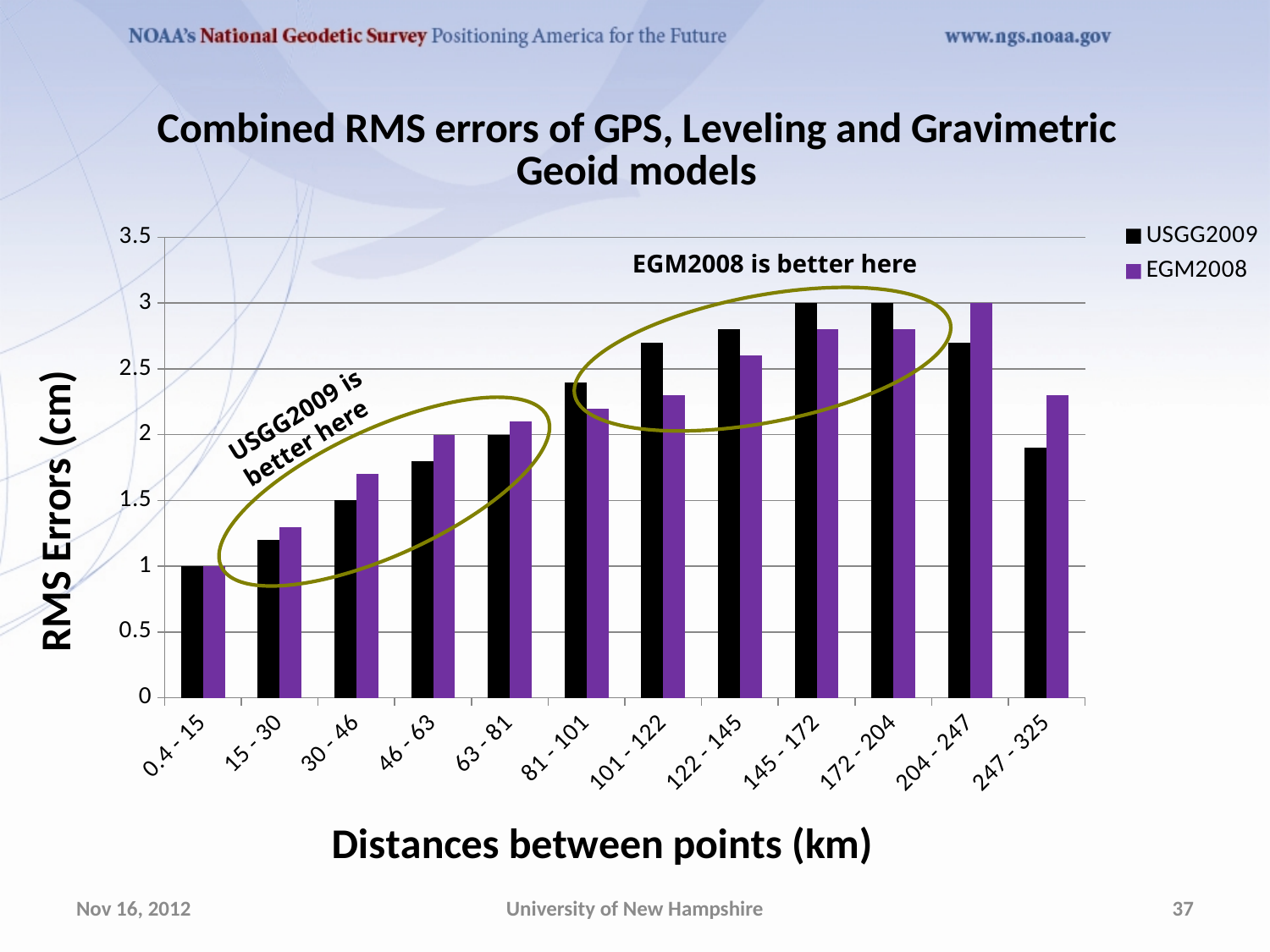
For which distance range is the USGG2009 RMS error lowest? 0.4 - 15 For the 247 - 325 km range, which series has the larger RMS error, USGG2009 or EGM2008? EGM2008 What is the label of the y axis? RMS Errors (cm) For which distance range is the EGM2008 RMS error highest? 204 - 247 What is the EGM2008 RMS error for the 204 - 247 km distance range? 3 How many distance categories are shown on the x axis? 12 Is the EGM2008 value for 247 - 325 km greater or less than 2? greater What is the USGG2009 RMS error for the 0.4 - 15 km distance range? 1 How many series does the legend list? 2 Is the USGG2009 value for 30 - 46 km greater or less than 2? less What kind of chart is shown on the slide? bar chart What is the USGG2009 RMS error for the 63 - 81 km distance range? 2